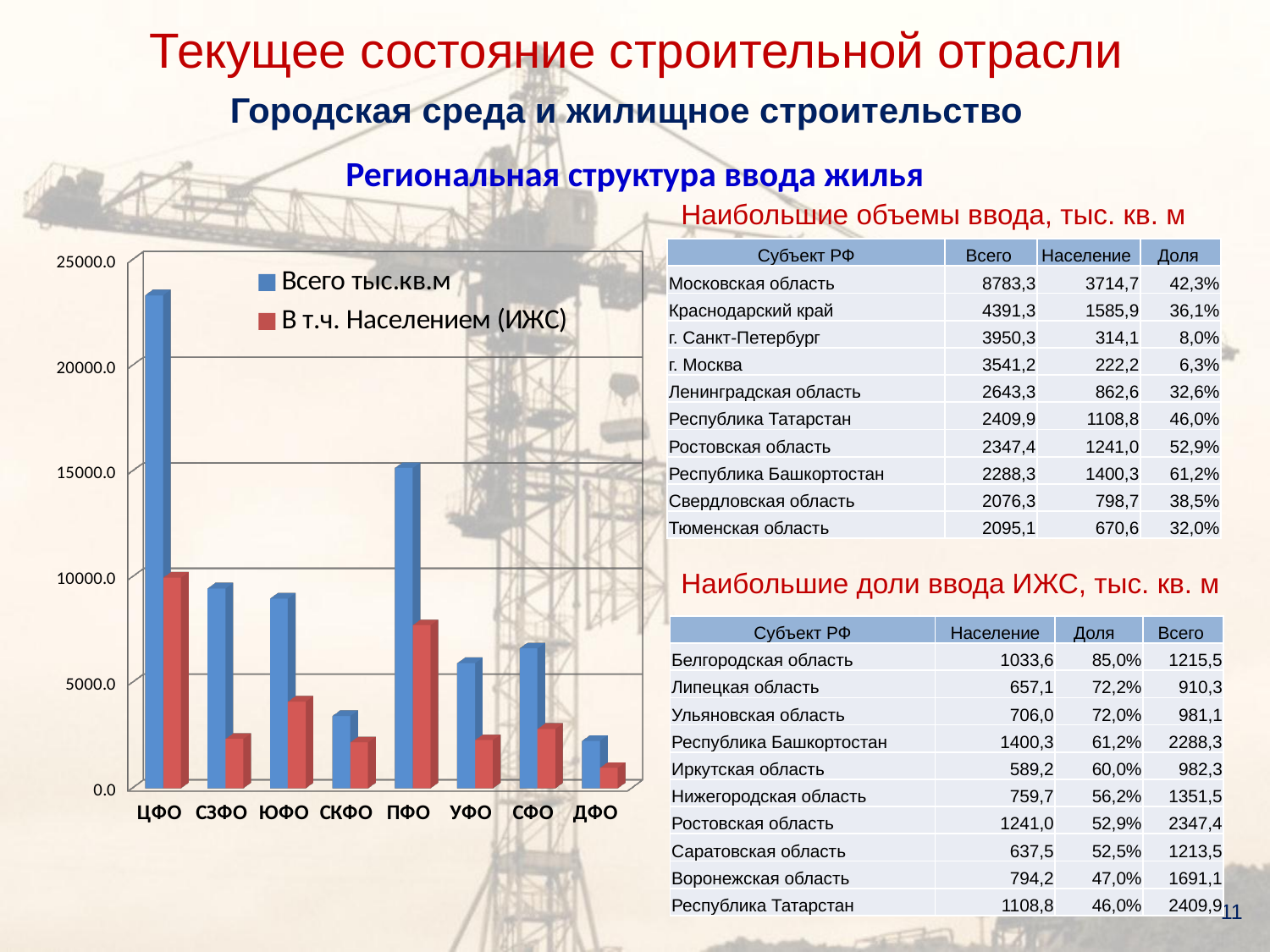
Which category has the lowest value for the series "В т.ч. Населением (ИЖС)"? ДФО Which category has the highest value for the series "Всего тыс.кв.м"? ЦФО Is the value for СКФО in the series "Всего тыс.кв.м" greater or less than 5000.0? less What colour are the bars for the series "В т.ч. Населением (ИЖС)"? red Which category has the lowest value for the series "Всего тыс.кв.м"? ДФО Which is larger for the series "Всего тыс.кв.м": ПФО or СЗФО? ПФО Which is larger for the series "В т.ч. Населением (ИЖС)": ЮФО or СЗФО? ЮФО What kind of chart is shown on the slide? bar chart How many federal districts (categories) are shown on the x axis of the chart? 8 How many series does the chart legend list? 2 Is the value for ПФО in the series "В т.ч. Населением (ИЖС)" greater or less than 10000.0? less Is the value for ЦФО in the series "Всего тыс.кв.м" greater or less than 20000.0? greater